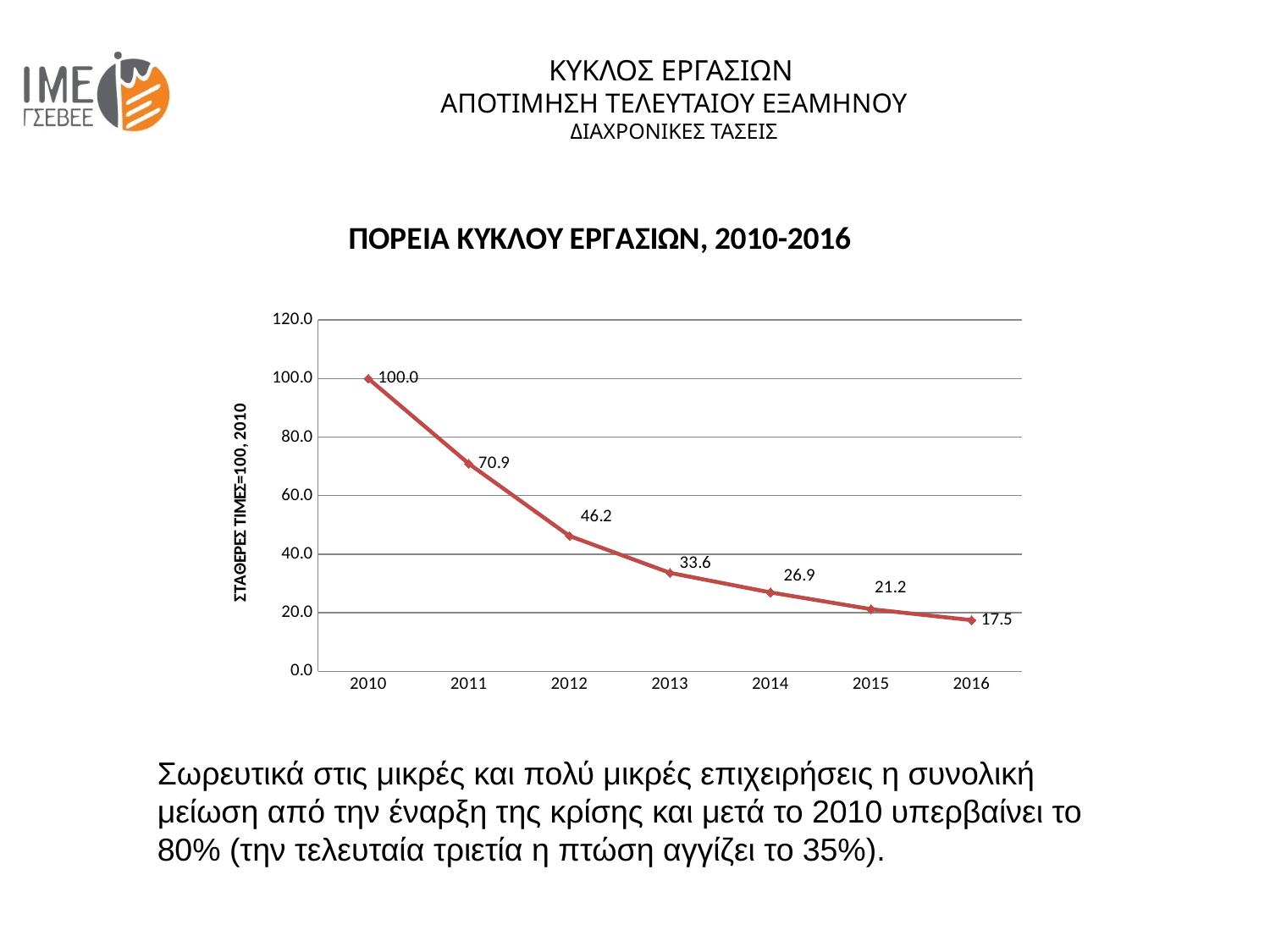
How many years are plotted on the chart? 7 Is the value for 2012 greater or less than 40.0? greater What is the difference between the values for 2012 and 2013? 12.6 Do the values rise or fall from 2010 to 2016? fall What is the difference between the values for 2010 and 2016? 82.5 Which year has the highest value? 2010 What is the value for 2016? 17.5 What is the value for 2014? 26.9 Which year has the lowest value? 2016 What is the value for 2011? 70.9 What kind of chart is shown? line chart Which is larger, the value for 2013 or the value for 2015? 2013